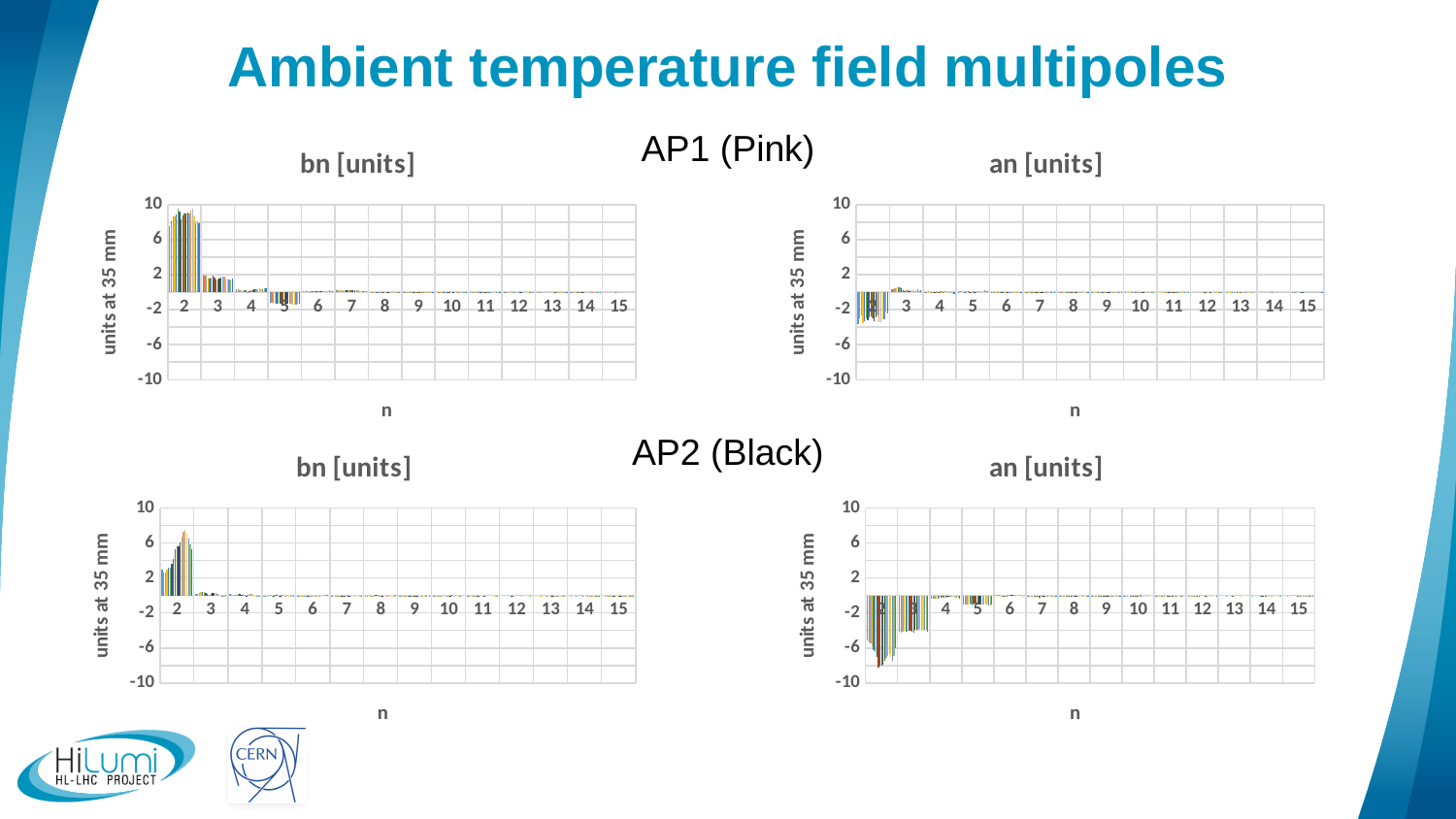
What is the x-axis title of the AP2 bn [units] chart (bottom left)? n In the AP2 bn [units] chart (bottom left), are the values at n = 3 greater or less than 2? less In the AP1 bn [units] chart (top left), are the values at n = 3 greater or less than 6? less In the AP1 an [units] chart (top right), are the values at n = 2 greater or less than 2? less What kind of chart is the AP1 bn [units] chart (top left)? bar chart What is the y-axis title of the AP2 an [units] chart (bottom right)? units at 35 mm In the AP1 bn [units] chart (top left), do the values rise or fall as n increases from 2 to 15? fall In the AP2 bn [units] chart (bottom left), at which value of n are the bars highest? 2 In the AP2 an [units] chart (bottom right), at which value of n are the bars lowest (most negative)? 2 How many values of n are shown on the x axis of the AP1 bn [units] chart (top left)? 14 In the AP1 bn [units] chart (top left), at which value of n are the bars highest? 2